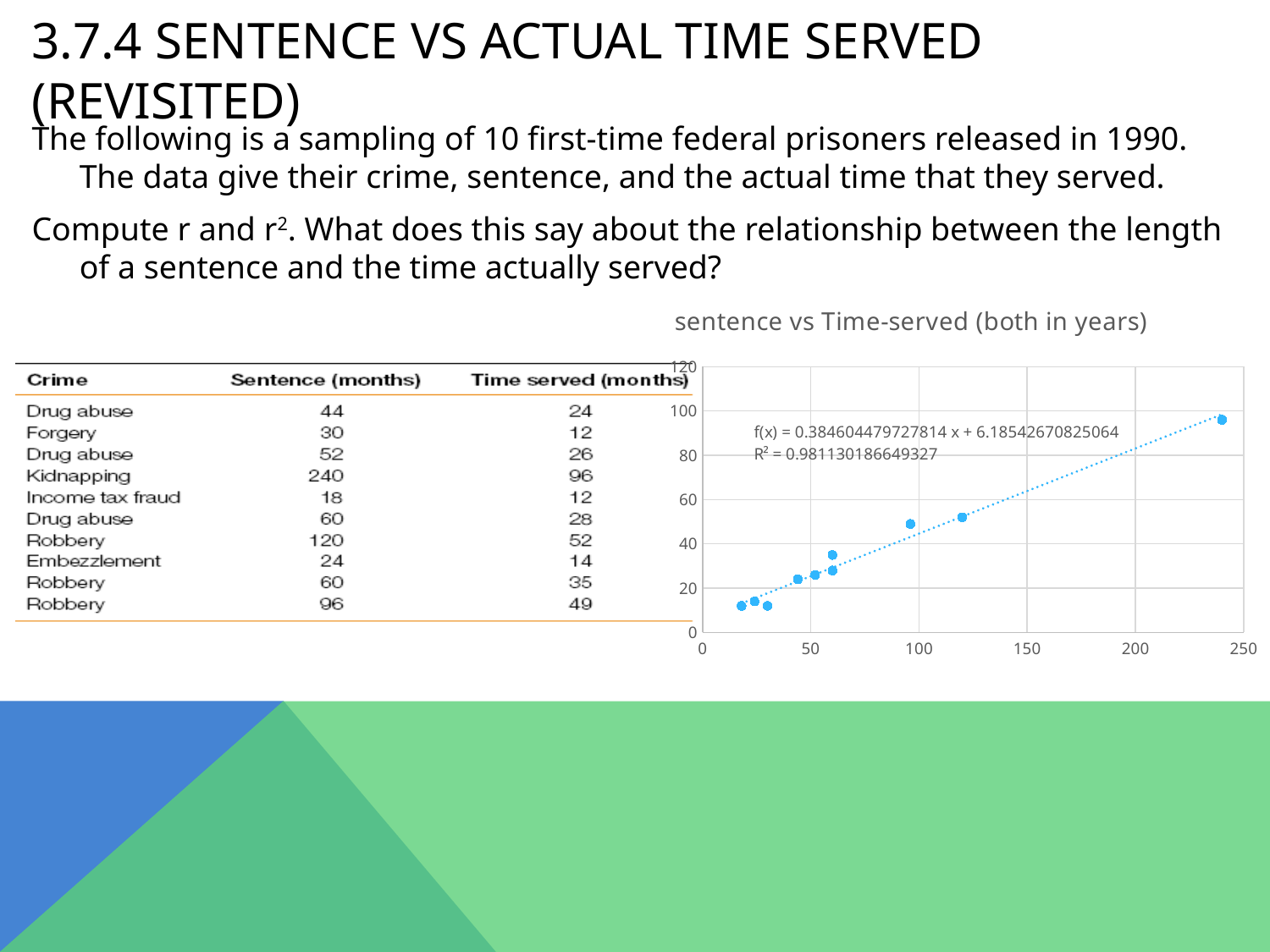
Is the x value of the rightmost point greater or less than 200? greater Do the plotted values rise or fall as the x-axis value increases? rise What kind of chart is shown on the slide? scatter chart How many data points are plotted in the scatter chart? 10 Is the y value of the point near x = 120 greater or less than 60? less What is the title of the chart? sentence vs Time-served (both in years) What R² value is printed on the chart? 0.981130186649327 Which point has the higher y value, the point near x = 240 or the point near x = 120? the point near x = 240 Is the y value of the rightmost point (near x = 240) greater or less than 80? greater